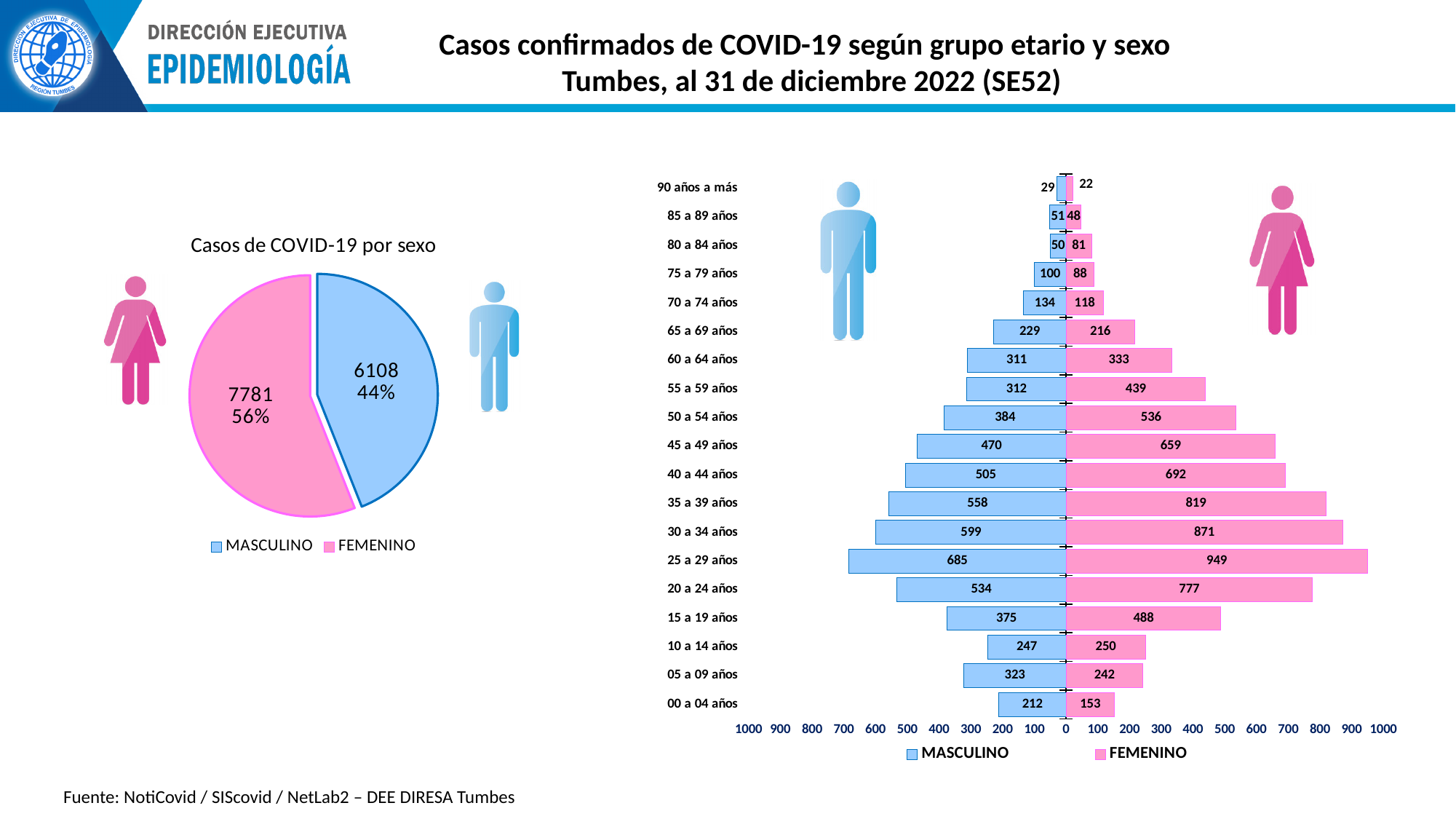
In the pie chart 'Casos de COVID-19 por sexo', which sex has the larger slice? FEMENINO What type of chart is the chart on the right of the slide? Bar chart How many age groups are shown in the population pyramid chart on the right? 19 In the population pyramid chart on the right, what is the MASCULINO value for the '25 a 29 años' group? 685 In the population pyramid chart on the right, what is the FEMENINO value for the '35 a 39 años' group? 819 In the pie chart 'Casos de COVID-19 por sexo', what percentage share does MASCULINO have? 44% In the population pyramid chart on the right, which age group has the lowest MASCULINO value? 90 años a más In the population pyramid chart on the right, which is larger for the '05 a 09 años' group, MASCULINO or FEMENINO? MASCULINO In the pie chart 'Casos de COVID-19 por sexo', what value is shown for FEMENINO? 7781 In the population pyramid chart on the right, which age group has the highest FEMENINO value? 25 a 29 años In the pie chart 'Casos de COVID-19 por sexo', what is the difference between the FEMENINO and MASCULINO values? 1673 In the population pyramid chart on the right, what is the difference between the FEMENINO and MASCULINO values for the '25 a 29 años' group? 264